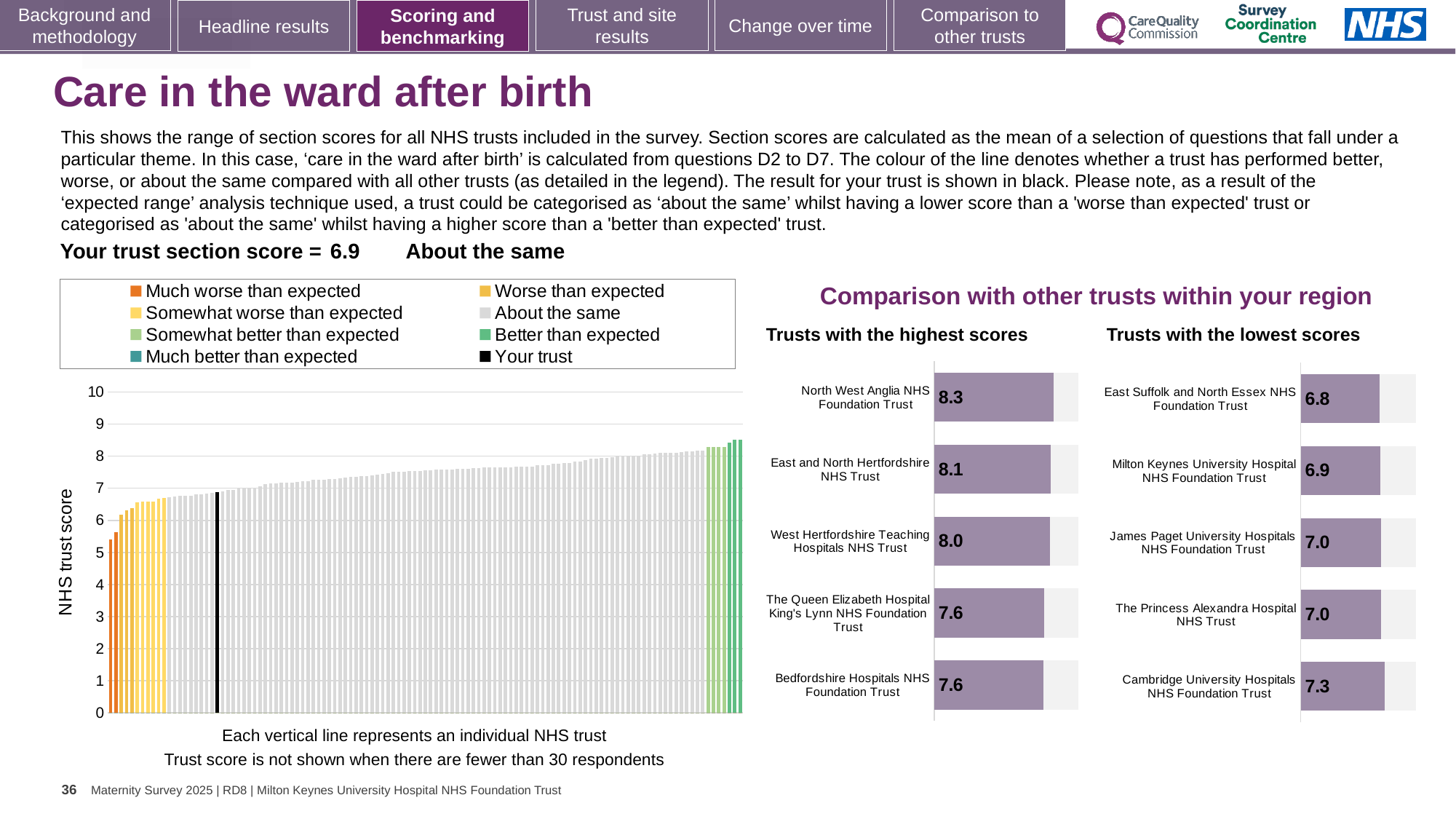
In the 'Trusts with the highest scores' chart, what is the score for North West Anglia NHS Foundation Trust? 8.3 What is the section score for your trust shown on the slide? 6.9 In the 'Trusts with the lowest scores' chart, which has the larger score: Milton Keynes University Hospital NHS Foundation Trust or Cambridge University Hospitals NHS Foundation Trust? Cambridge University Hospitals NHS Foundation Trust In the 'Trusts with the lowest scores' chart, which trust has the lowest score? East Suffolk and North Essex NHS Foundation Trust In the large chart on the left showing NHS trust scores, do the values rise or fall from left to right? rise In the 'Trusts with the lowest scores' chart, what is the score for James Paget University Hospitals NHS Foundation Trust? 7.0 In the 'Trusts with the lowest scores' chart, what is the difference between the scores of Cambridge University Hospitals NHS Foundation Trust and East Suffolk and North Essex NHS Foundation Trust? 0.5 In the 'Trusts with the highest scores' chart, what is the difference between the scores of North West Anglia NHS Foundation Trust and Bedfordshire Hospitals NHS Foundation Trust? 0.7 How many trusts are shown in the 'Trusts with the highest scores' chart? 5 How many entries does the legend above the large chart on the left list? 8 What kind of chart is the large chart on the left showing NHS trust scores? bar chart In the 'Trusts with the highest scores' chart, which trust has the highest score? North West Anglia NHS Foundation Trust